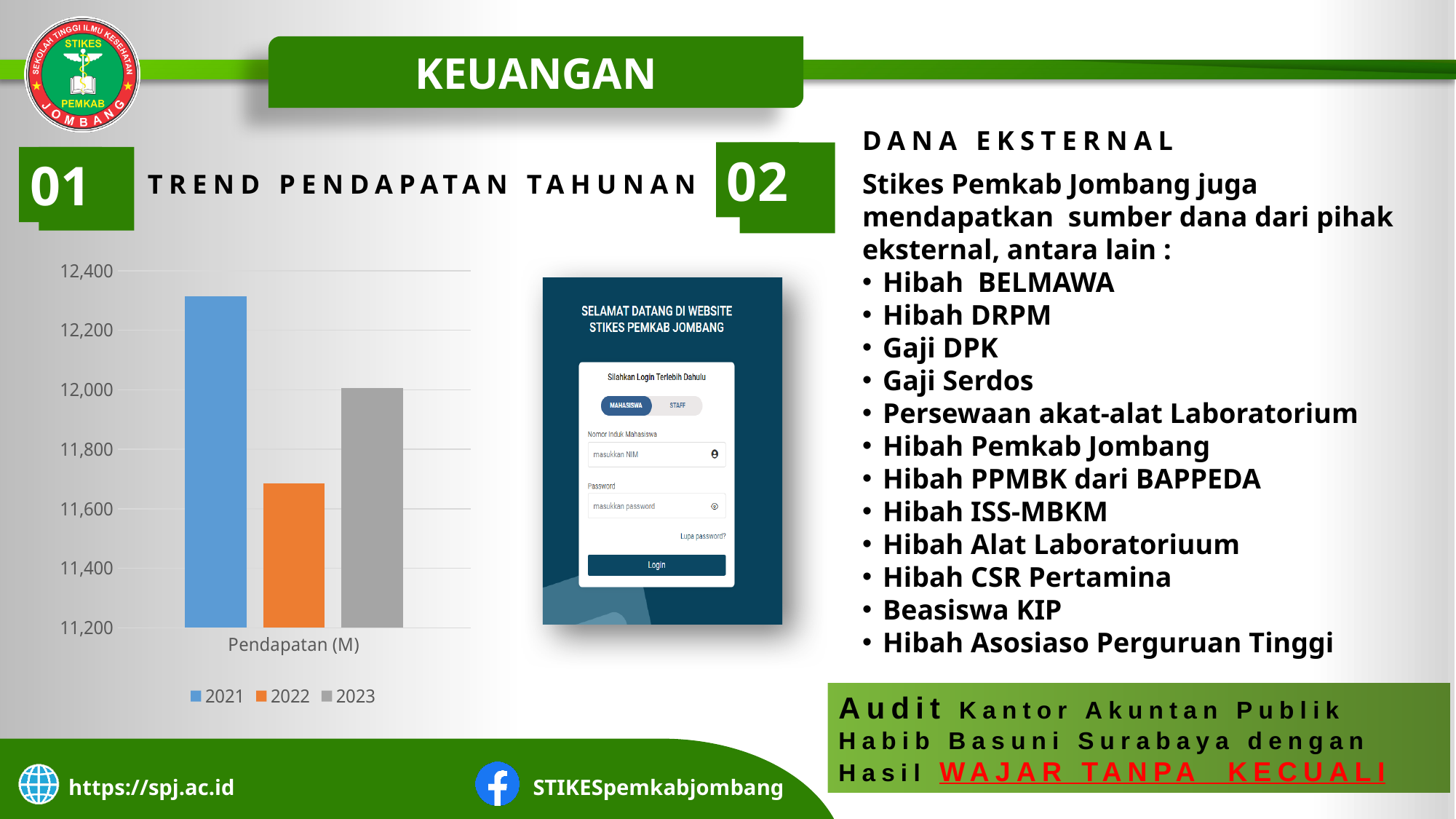
Is the value for 2021 in the bar chart greater or less than 12,200? greater What is the category label shown on the x axis of the bar chart? Pendapatan (M) Which year has the highest bar in the bar chart? 2021 How many series does the legend of the bar chart list? 3 What kind of chart is shown under 'TREND PENDAPATAN TAHUNAN'? bar chart Is the value for 2023 in the bar chart greater or less than 12,200? less Which year has the lowest bar in the bar chart? 2022 In the bar chart, which is larger, the value for 2021 or the value for 2023? 2021 Which years are listed in the legend of the bar chart? 2021, 2022, 2023 In the bar chart, is the value for 2023 larger than the value for 2022? yes Is the value for 2022 in the bar chart greater or less than 11,800? less How many categories are shown on the x axis of the bar chart? 1